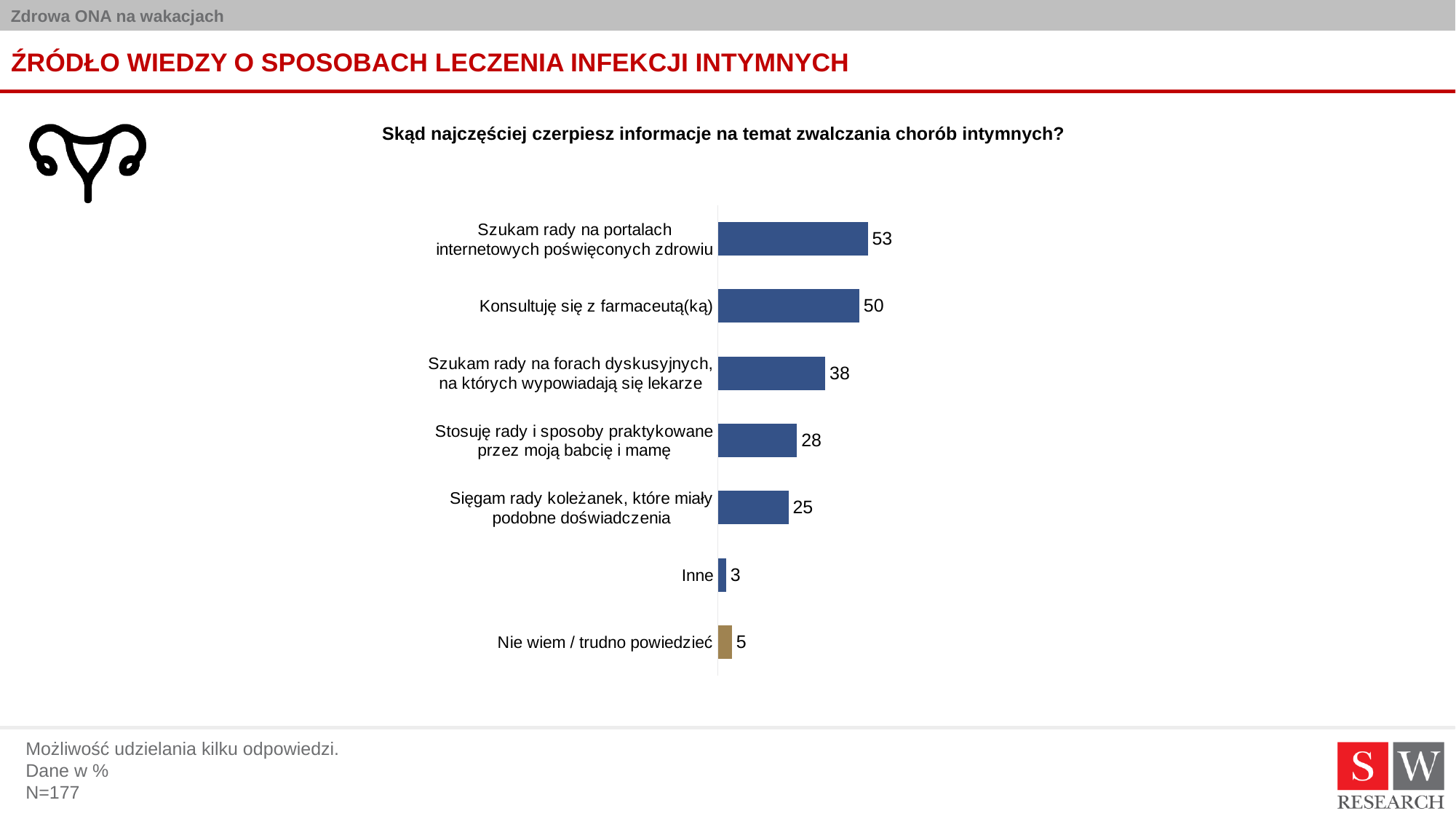
Which is larger: the value for "Szukam rady na forach dyskusyjnych, na których wypowiadają się lekarze" or the value for "Stosuję rady i sposoby praktykowane przez moją babcię i mamę"? Szukam rady na forach dyskusyjnych, na których wypowiadają się lekarze How many categories are shown in the chart? 7 What is the difference between the values for "Stosuję rady i sposoby praktykowane przez moją babcię i mamę" and "Sięgam rady koleżanek, które miały podobne doświadczenia"? 3 What value is shown for "Szukam rady na forach dyskusyjnych, na których wypowiadają się lekarze"? 38 What value is shown for "Konsultuję się z farmaceutą(ką)"? 50 What value is shown for "Inne"? 3 What kind of chart is shown on the slide? Bar chart Which category has the lowest value? Inne What is the difference between the values for "Szukam rady na portalach internetowych poświęconych zdrowiu" and "Konsultuję się z farmaceutą(ką)"? 3 Which category has the highest value? Szukam rady na portalach internetowych poświęconych zdrowiu What question is shown as the chart's title? Skąd najczęściej czerpiesz informacje na temat zwalczania chorób intymnych? What value is shown for "Nie wiem / trudno powiedzieć"? 5